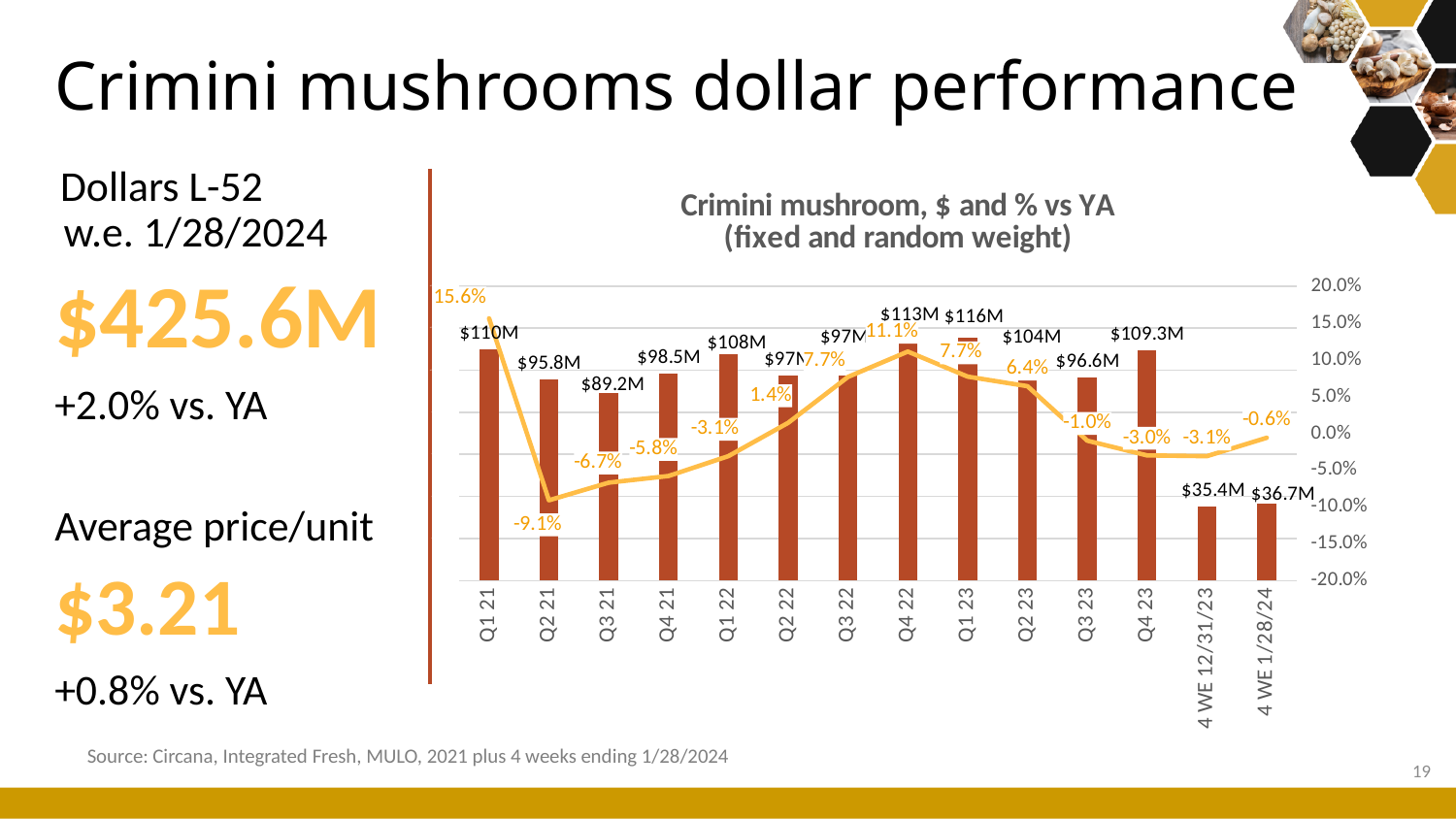
What is the % vs YA value for Q4 22 in the Crimini mushroom chart? 11.1% What is the difference in dollar value between Q4 23 and Q3 23 in the Crimini mushroom chart? $12.7M Which quarter has the highest dollar value in the Crimini mushroom chart? Q1 23 What kind of chart is the Crimini mushroom chart? Combined bar and line chart Does the % vs YA line rise or fall from Q2 21 to Q4 22 in the Crimini mushroom chart? Rise What is the dollar value for the 4 WE 1/28/24 period in the Crimini mushroom chart? $36.7M Which period has the lowest % vs YA value in the Crimini mushroom chart? Q2 21 Which has the larger dollar value in the Crimini mushroom chart, Q1 21 or Q1 22? Q1 21 How many periods are shown on the x axis of the Crimini mushroom chart? 14 What is the % vs YA value for Q1 21 in the Crimini mushroom chart? 15.6% What is the title of the chart on the slide? Crimini mushroom, $ and % vs YA (fixed and random weight) What is the dollar value for Q1 23 in the Crimini mushroom chart? $116M